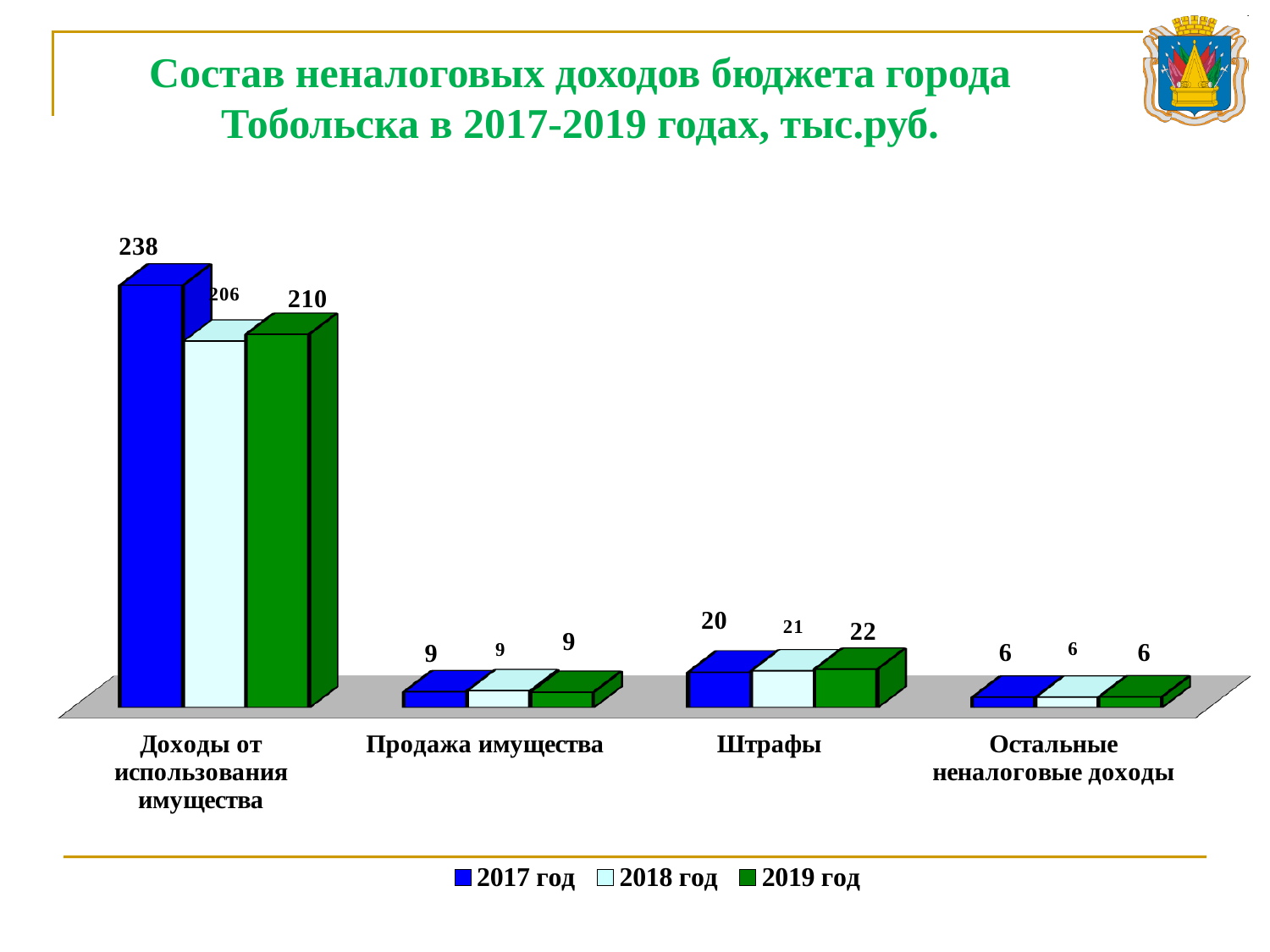
What is the value for Штрафы in 2019 год? 22 Which category has the lowest value in 2017 год? Остальные неналоговые доходы What kind of chart is shown on the slide? bar chart How many series does the legend list? 3 Which category has the highest value in 2019 год? Доходы от использования имущества How many categories are shown on the x axis? 4 What is the difference between the 2017 год and 2018 год values for Доходы от использования имущества? 32 What is the value for Остальные неналоговые доходы in 2018 год? 6 Which series is shown in green in the legend? 2019 год Which is larger for Штрафы: the 2017 год value or the 2019 год value? 2019 год What is the value for Доходы от использования имущества in 2017 год? 238 What is the value for Доходы от использования имущества in 2018 год? 206